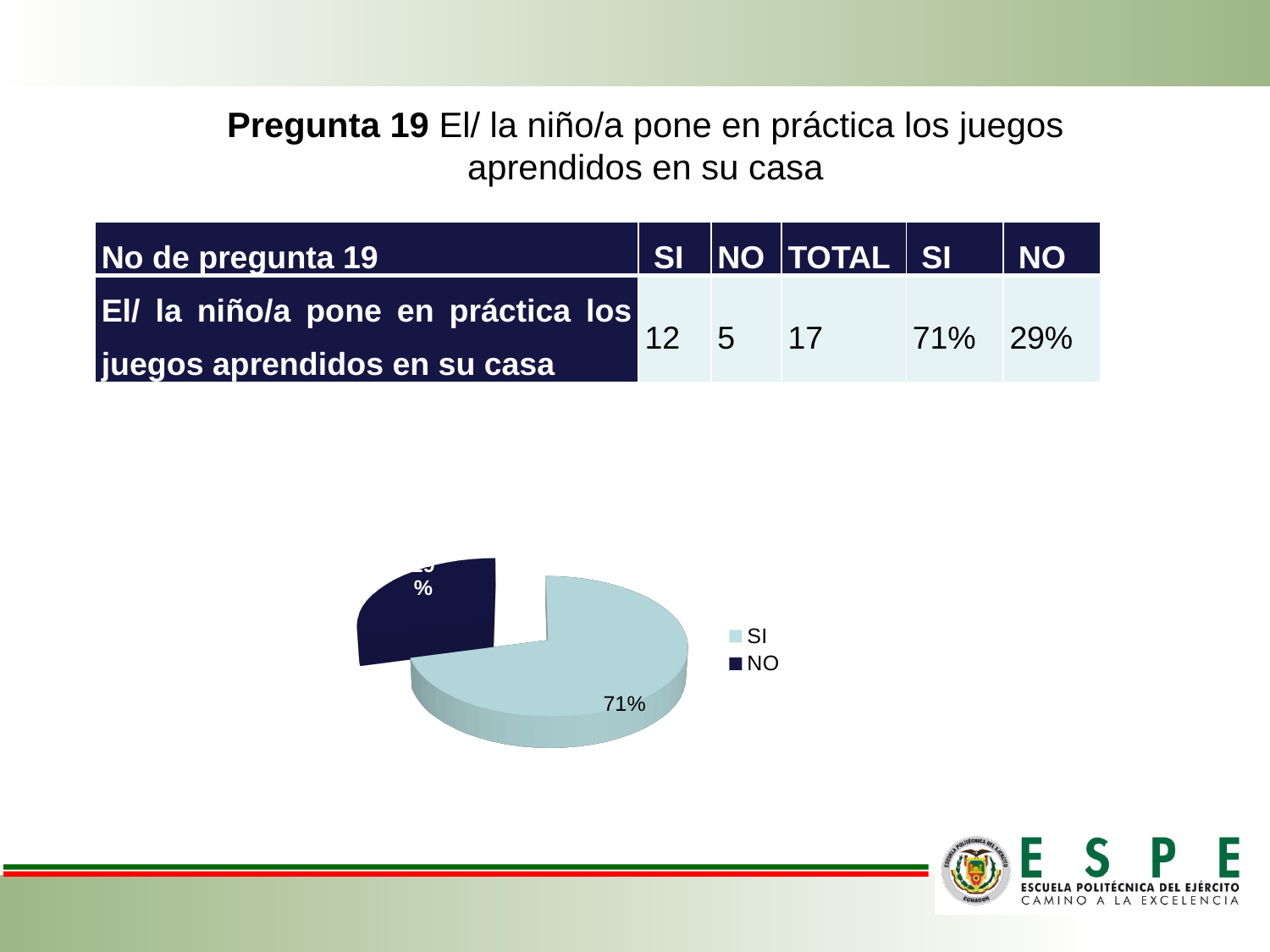
Which slice of the pie chart is the smallest? NO Which slice of the pie chart is the largest? SI What share of the pie chart does the NO slice represent? 29% Which legend entry of the pie chart is shown in dark navy blue? NO What kind of chart is shown on the slide? pie chart What is the difference in percentage points between the SI and NO slices of the pie chart? 42 What share of the pie chart does the SI slice represent? 71% Is the share of the SI slice greater or less than 50%? greater Which legend entry of the pie chart is shown in light blue? SI How many entries does the legend of the pie chart list? 2 How many slices does the pie chart have? 2 Which is larger in the pie chart, SI or NO? SI